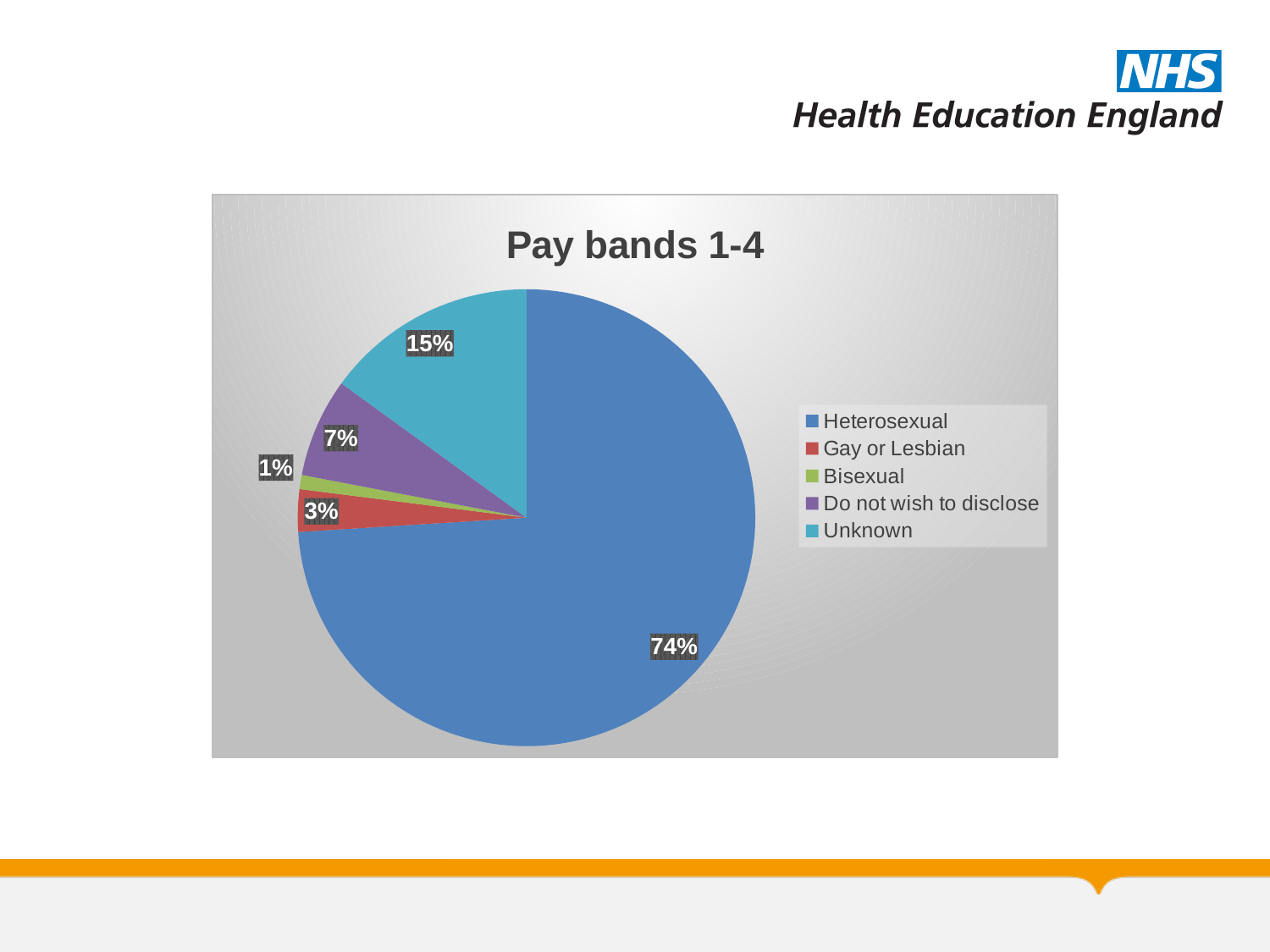
How many categories does the legend list? 5 Which is larger, the Gay or Lesbian slice or the Bisexual slice? Gay or Lesbian What percentage of the pie is Gay or Lesbian? 3% What percentage of the pie is Do not wish to disclose? 7% What is the difference in percentage points between the Unknown slice and the Do not wish to disclose slice? 8 What percentage of the pie is Unknown? 15% What percentage of the pie is Heterosexual? 74% What is the title of the chart? Pay bands 1-4 Which category has the largest slice of the pie? Heterosexual Which category has the smallest slice of the pie? Bisexual What kind of chart is shown on the slide? pie chart What percentage of the pie is Bisexual? 1%